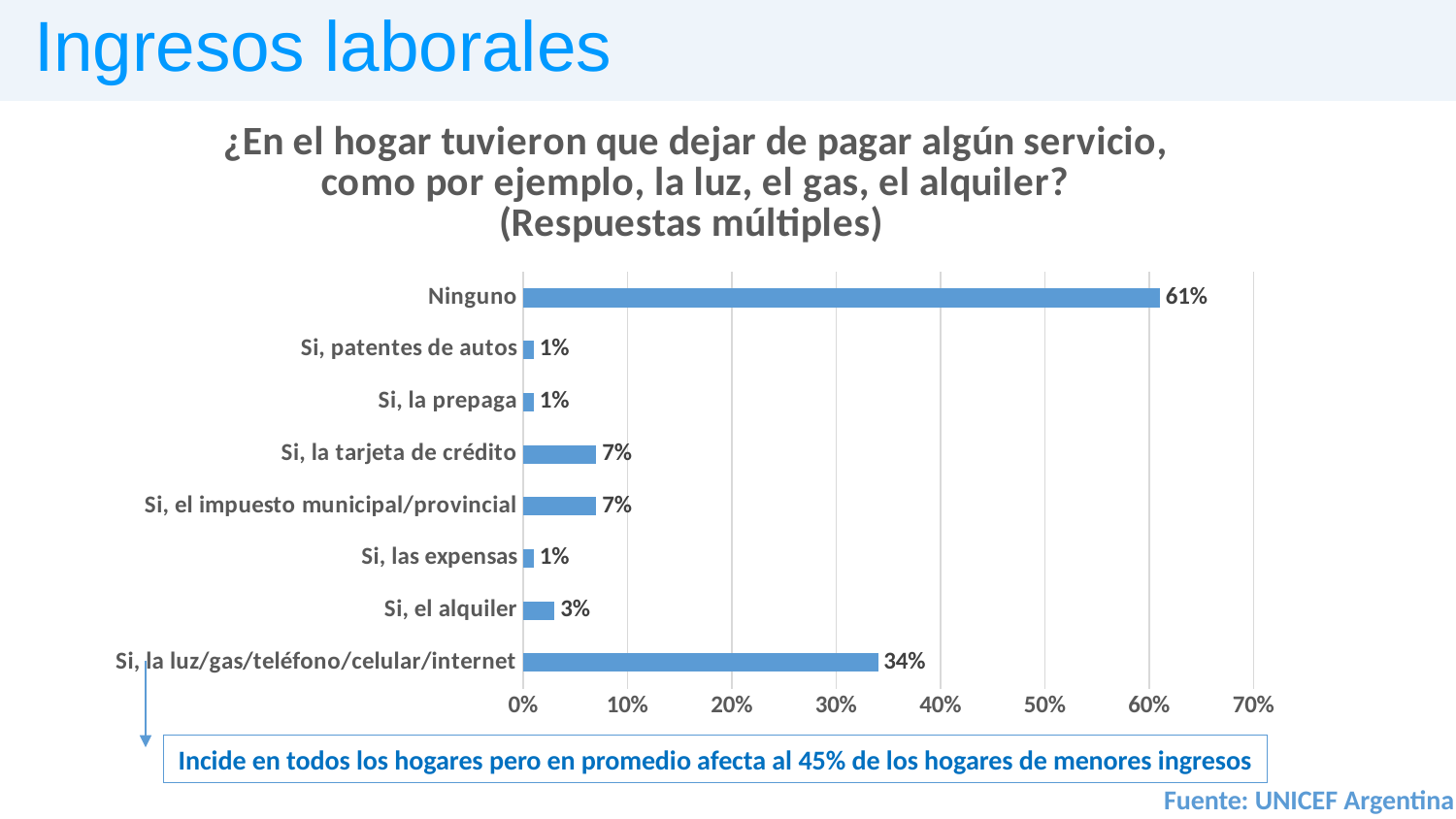
What is the value for "Si, la luz/gas/teléfono/celular/internet"? 34% Is the value for "Ninguno" greater or less than 50%? greater What kind of chart is shown on the slide? bar chart What is the value for "Si, el alquiler"? 3% What is the value for "Si, la tarjeta de crédito"? 7% Which is larger, the value for "Si, el alquiler" or the value for "Si, las expensas"? Si, el alquiler How many categories are shown in the chart? 8 How many categories have a value of 1%? 3 What is the difference between the values for "Ninguno" and "Si, la luz/gas/teléfono/celular/internet"? 27% Which category has the highest value? Ninguno What is the source cited for the chart? UNICEF Argentina What is the value for "Ninguno"? 61%